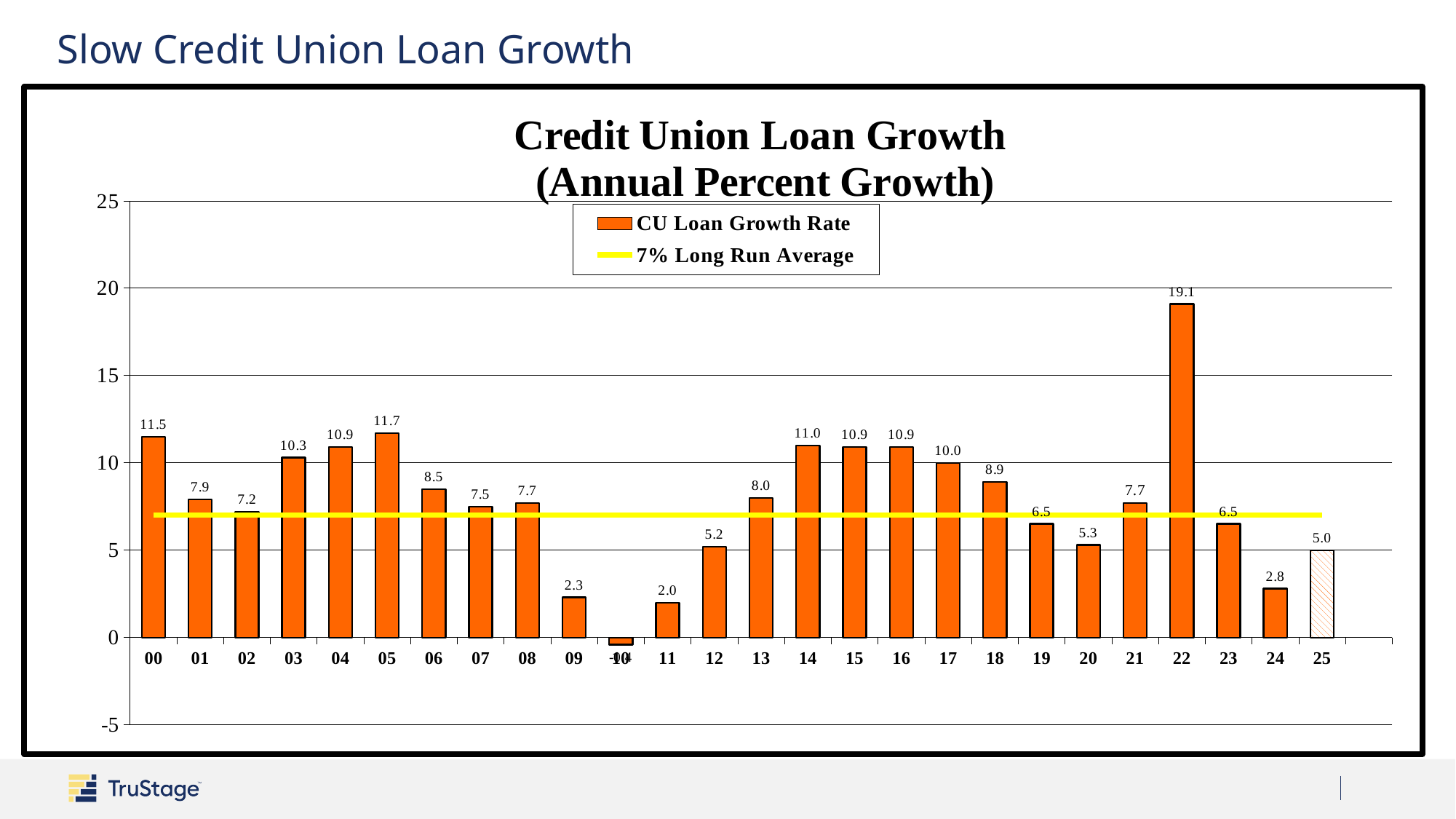
How many years are shown on the x axis? 26 What is the CU Loan Growth Rate for 25? 5.0 Which year has the highest CU Loan Growth Rate? 22 What is the difference between the CU Loan Growth Rate for 22 and for 23? 12.6 What is the CU Loan Growth Rate for 22? 19.1 How many series does the legend list? 2 Which year has the lowest CU Loan Growth Rate? 10 Is the CU Loan Growth Rate for 14 greater or less than 10? greater What kind of chart is used to show the CU Loan Growth Rate? bar chart Which year has a higher CU Loan Growth Rate, 09 or 24? 24 What is the CU Loan Growth Rate for 05? 11.7 What value does the yellow line in the chart represent? 7% Long Run Average